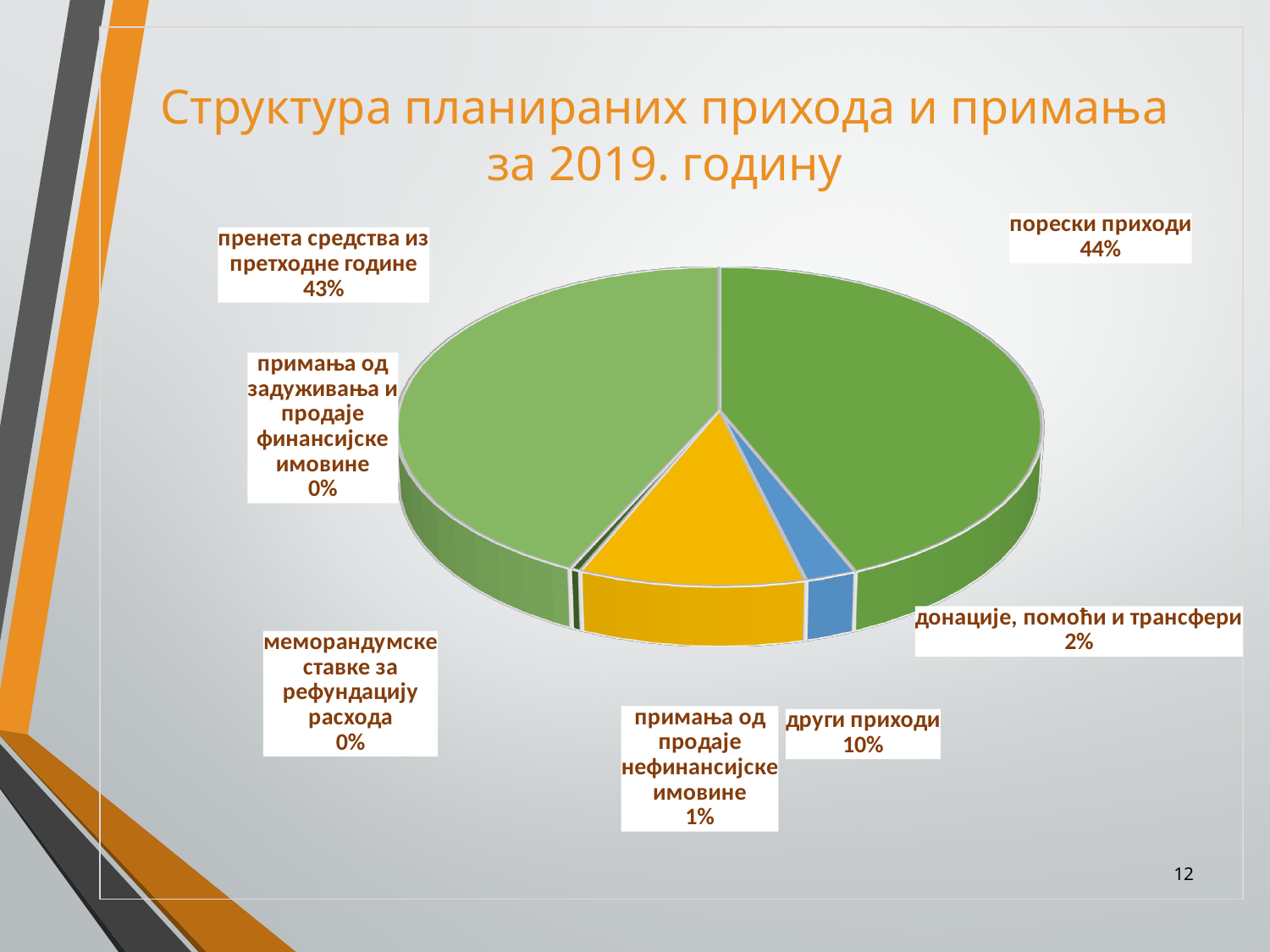
What percentage is shown for донације, помоћи и трансфери? 2% What is the difference in percentage points between други приходи and донације, помоћи и трансфери? 8 What is the title of the slide? Структура планираних прихода и примања за 2019. годину What kind of chart is shown on the slide? pie chart What share of the pie does порески приходи represent? 44% What percentage is shown for пренета средства из претходне године? 43% What is the difference in percentage points between порески приходи and други приходи? 34 Which category has the largest share of the pie? порески приходи How many categories are labelled on the pie chart? 7 What percentage is shown for други приходи? 10% What percentage is shown for примања од продаје нефинансијске имовине? 1% Which is larger, the share for порески приходи or the share for пренета средства из претходне године? порески приходи